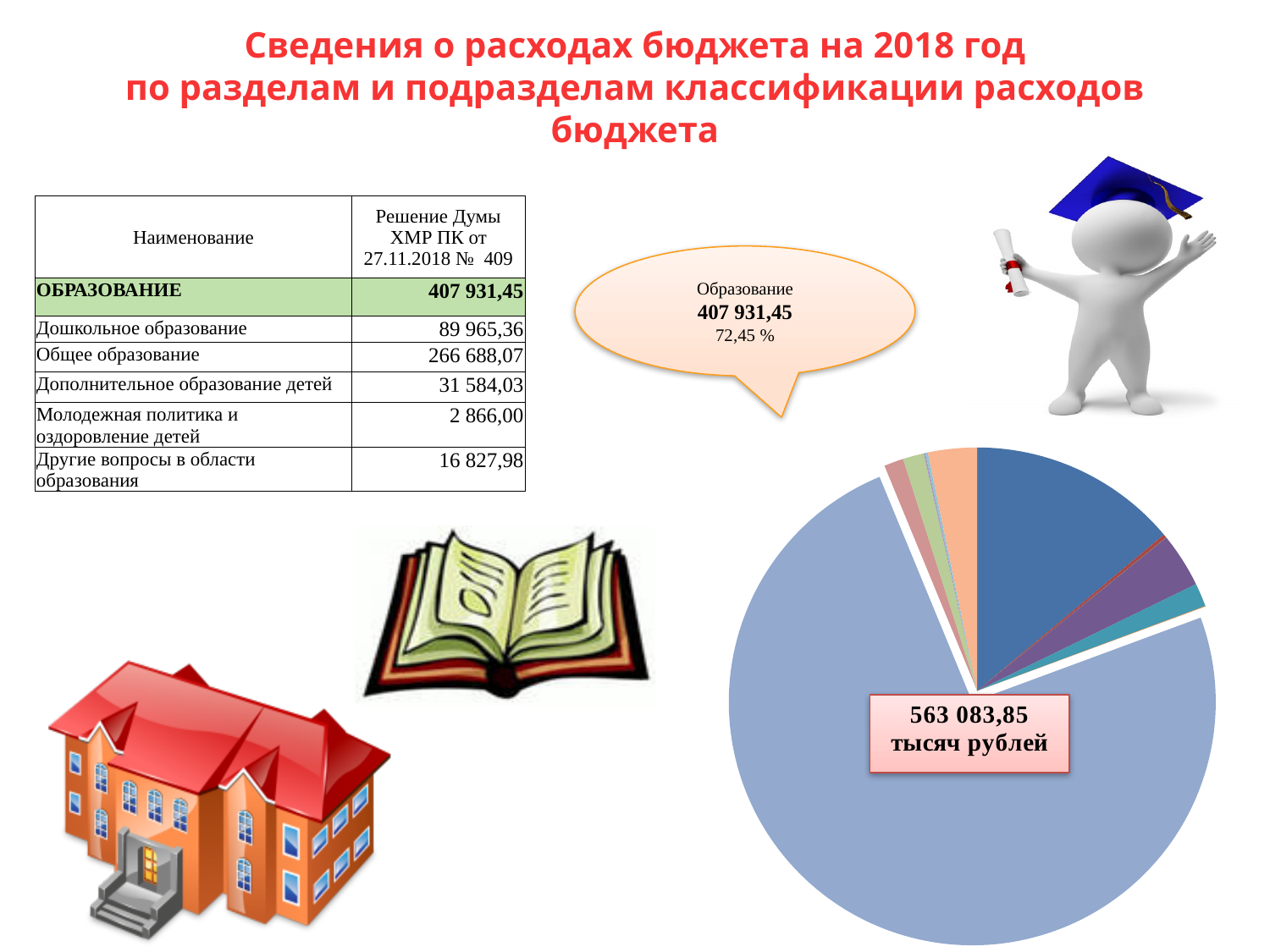
Is the share of the pie for Образование greater or less than 50%? greater What total is printed in the box on the pie chart? 563 083,85 тысяч рублей Does the pie chart have a legend listing its categories? No What kind of chart is shown on the slide? pie chart Which category does the callout on the pie chart identify as the largest slice? Образование What share of the pie does the callout give for Образование? 72,45 % What value does the callout give for Образование on the pie chart? 407 931,45